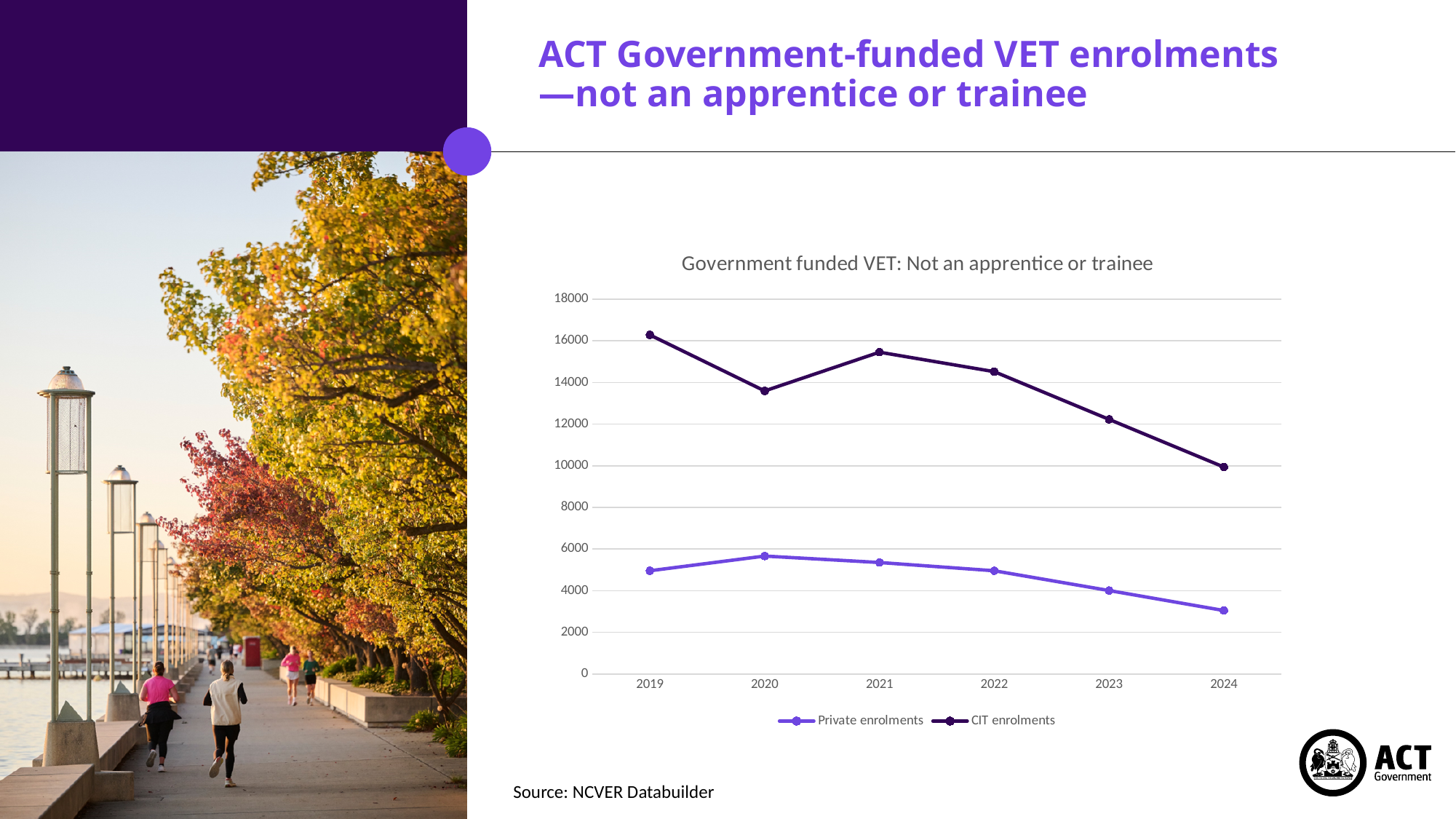
How many series does the chart legend list? 2 How many years are plotted along the x axis of the chart? 6 What kind of chart is shown on the slide? line chart In which year are Private enrolments highest? 2020 Is the value for CIT enrolments in 2020 greater or less than 14000? less Is the value for Private enrolments in 2020 greater or less than 6000? less In which year are Private enrolments lowest? 2024 What is the title of the chart? Government funded VET: Not an apprentice or trainee Is the value for CIT enrolments in 2019 greater or less than 16000? greater In which year are CIT enrolments lowest? 2024 In which year are CIT enrolments highest? 2019 In 2024, which series has the larger value, Private enrolments or CIT enrolments? CIT enrolments